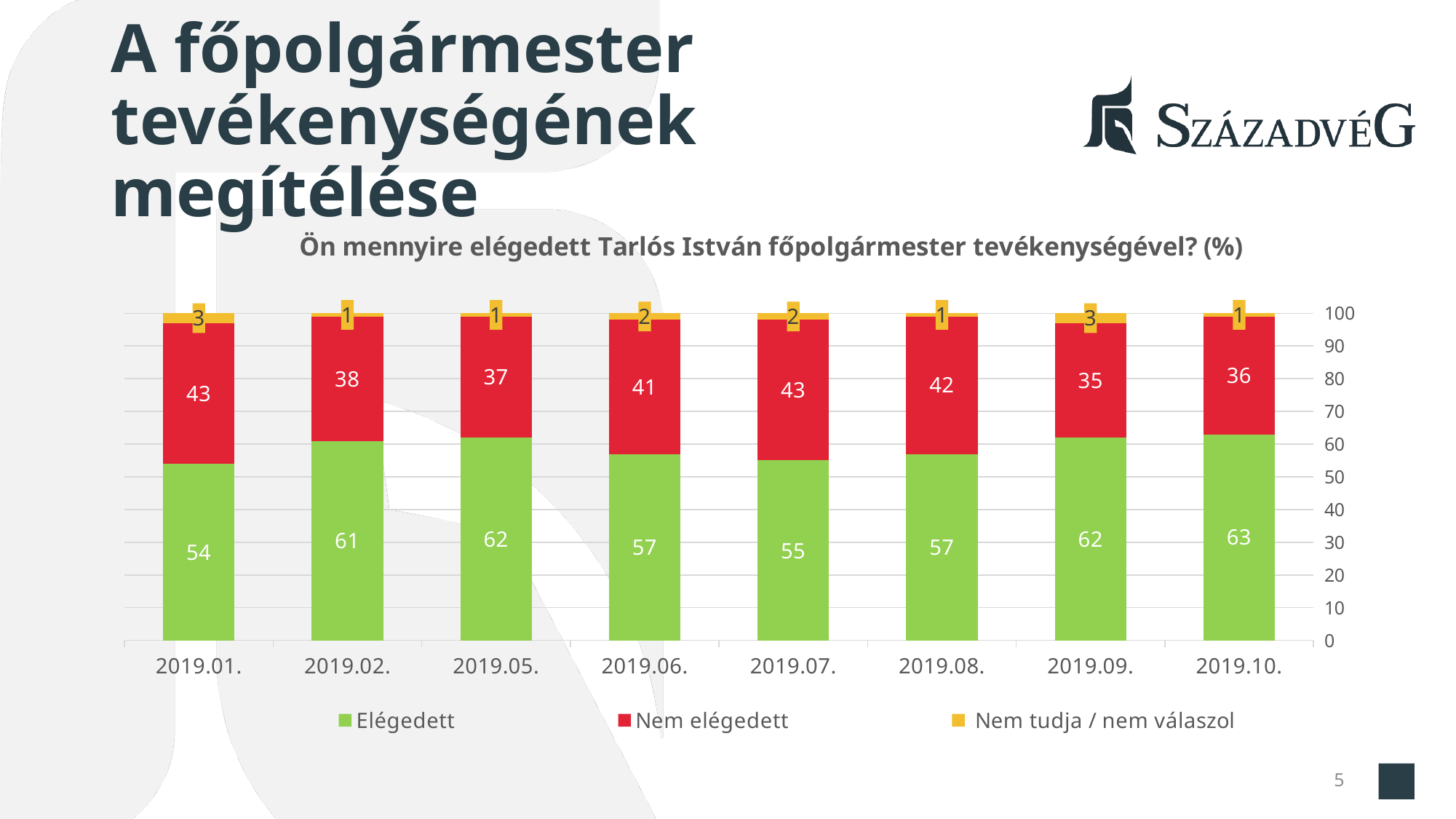
Which colour represents Nem elégedett in the legend? Red In which month is the Elégedett value highest? 2019.10. What is the value for Elégedett in 2019.01.? 54 Which is larger, the Elégedett value for 2019.07. or for 2019.08.? 2019.08. What kind of chart is shown on the slide? Stacked bar chart In which month is the Elégedett value lowest? 2019.01. What is the value for Nem elégedett in 2019.09.? 35 What is the difference between the Nem elégedett values for 2019.01. and 2019.02.? 5 What is the total of the stacked bar for 2019.05.? 100 How many months are shown on the x axis? 8 What is the value for Nem tudja / nem válaszol in 2019.06.? 2 How many series does the legend list? 3